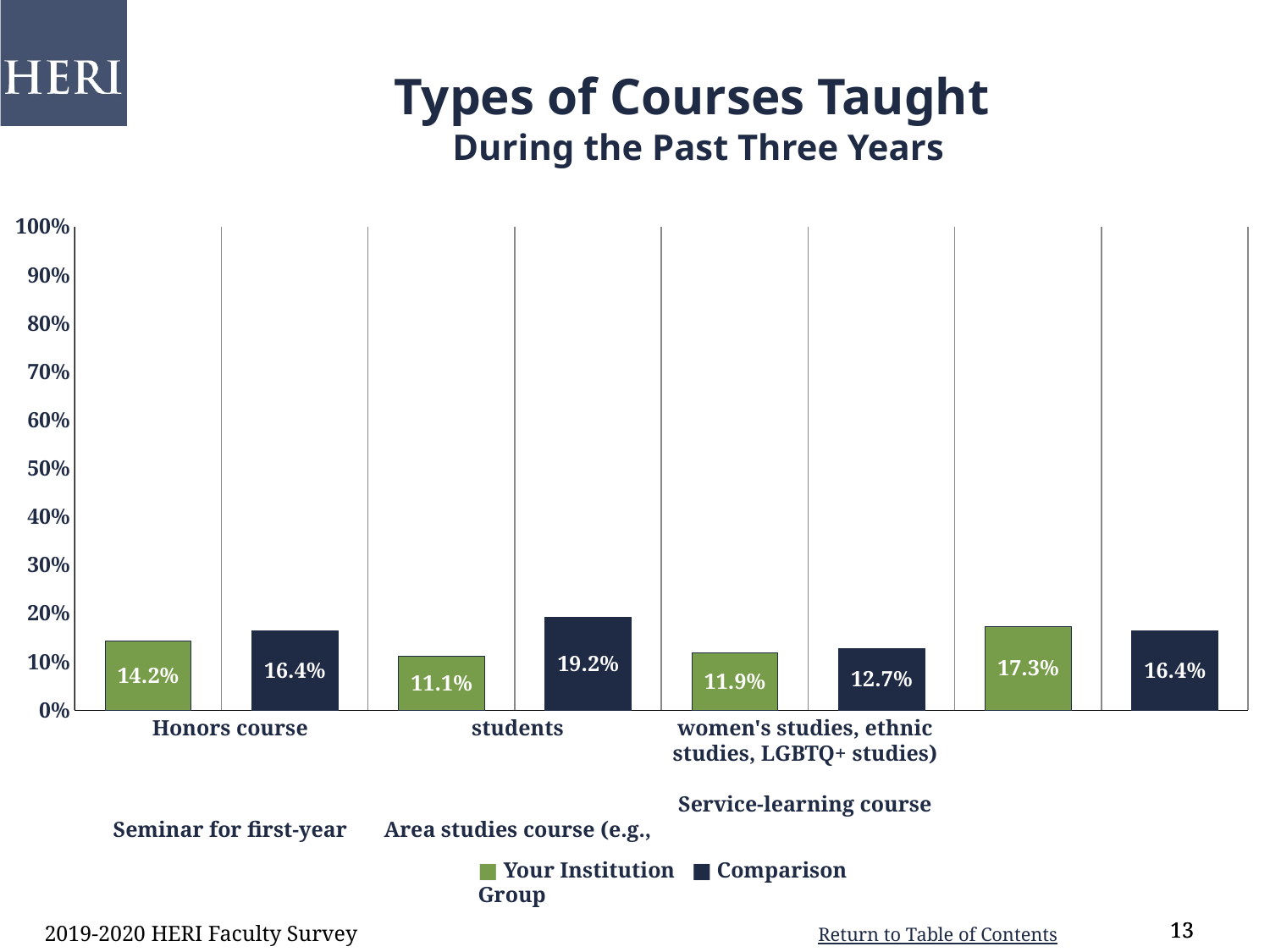
How many series does the legend list? 2 Which course type has the highest Your Institution value? Service-learning course What kind of chart is shown on the slide? Bar chart Which course type has the highest Comparison Group value? Seminar for first-year students What is the Comparison Group value for Area studies course? 12.7% What is the difference between the Comparison Group and Your Institution values for Seminar for first-year students? 8.1% What is the Comparison Group value for Seminar for first-year students? 19.2% For Service-learning course, which is larger: Your Institution or Comparison Group? Your Institution What is the value for Your Institution for Honors course? 14.2% What is the Your Institution value for Service-learning course? 17.3% Which course type has the lowest Your Institution value? Seminar for first-year students Is the Comparison Group value for Honors course greater or less than 20%? less